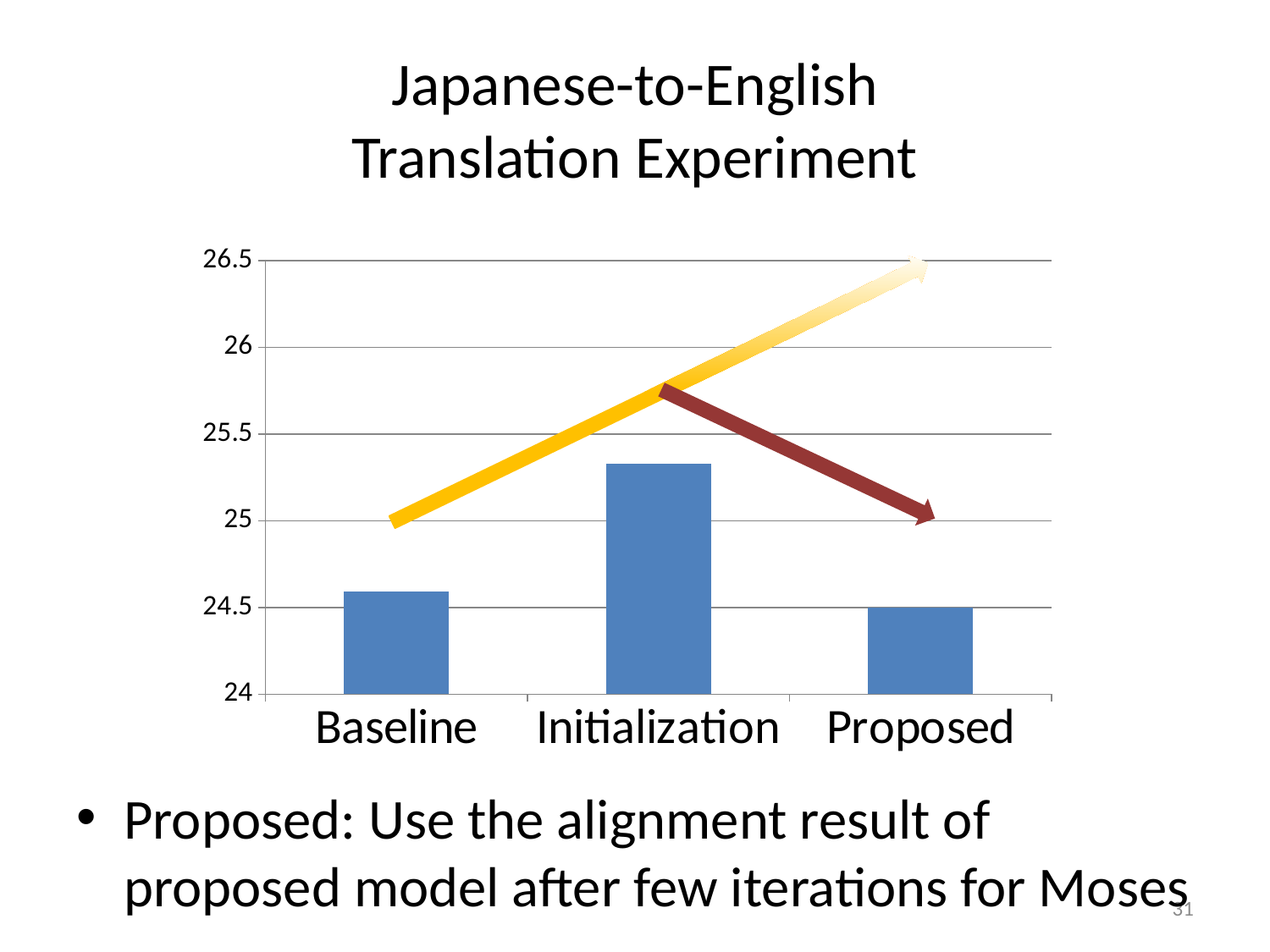
Which category has the highest bar in the chart? Initialization What type of chart is shown on the slide? bar chart How many categories are shown on the x axis of the chart? 3 Is the value for Proposed greater or less than 25? less Is the value for Baseline greater or less than 25? less Is the value for Baseline greater or less than 24.5? greater Do the bar values rise or fall from Initialization to Proposed? fall Which is larger, the value for Initialization or the value for Baseline? Initialization What is the highest value shown on the chart's vertical axis? 26.5 Which category has the lowest bar in the chart? Proposed